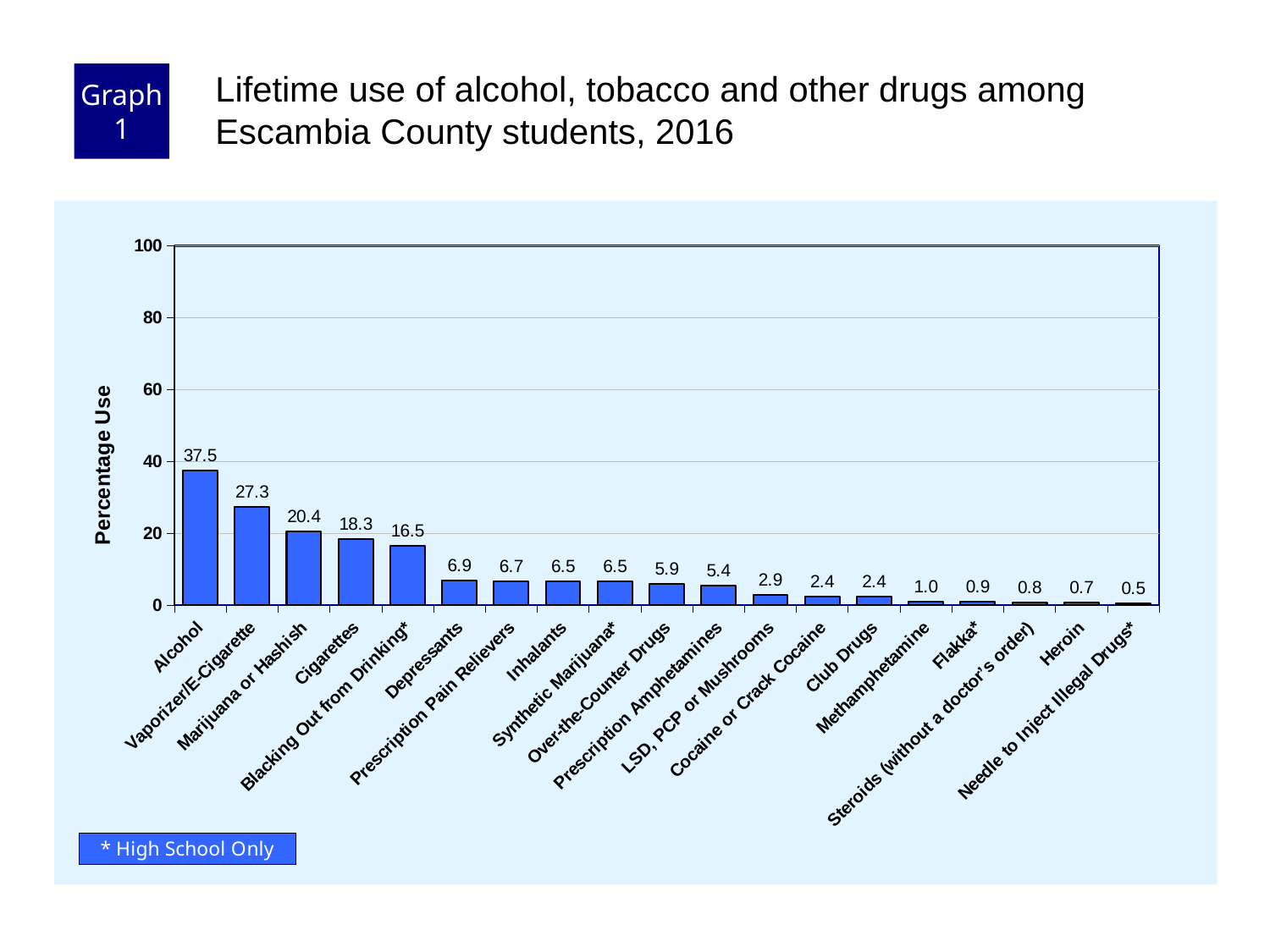
How many categories are shown on the x axis? 19 Which category has the lowest value? Needle to Inject Illegal Drugs* What is the value shown for Prescription Amphetamines? 5.4 What is the value shown for Cigarettes? 18.3 What is the lifetime use percentage for Alcohol? 37.5 What is the difference between the values for Alcohol and Vaporizer/E-Cigarette? 10.2 Which category has the highest value? Alcohol Which is larger, the value for Marijuana or Hashish or the value for Blacking Out from Drinking*? Marijuana or Hashish What is the value shown for Heroin? 0.7 What is the label on the y axis? Percentage Use Is the value for Vaporizer/E-Cigarette greater or less than 20? greater What kind of chart is shown on the slide? Bar chart